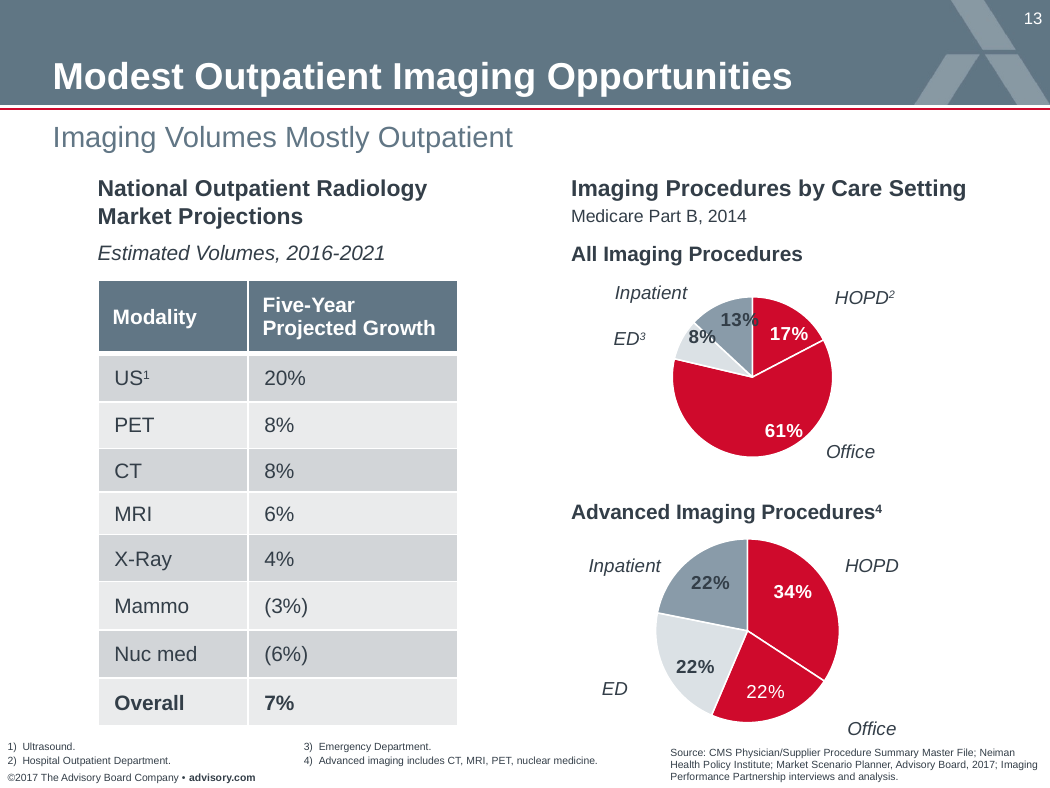
In the All Imaging Procedures pie chart, what share of procedures is in the HOPD setting? 17% Which is larger: the Inpatient share in the All Imaging Procedures chart or the Inpatient share in the Advanced Imaging Procedures chart? Advanced Imaging Procedures (22%) In the All Imaging Procedures pie chart, what share of procedures is in the Office setting? 61% In the All Imaging Procedures pie chart, what is the difference between the Office share and the HOPD share? 44 percentage points In the All Imaging Procedures pie chart, what share of procedures is Inpatient? 13% In the Advanced Imaging Procedures pie chart, which care setting has the largest share? HOPD In the Advanced Imaging Procedures pie chart, what share of procedures is in the HOPD setting? 34% In the Advanced Imaging Procedures pie chart, what share of procedures is in the Office setting? 22% In the All Imaging Procedures pie chart, which care setting has the smallest share? ED What type of chart is used to show Imaging Procedures by Care Setting? Pie chart How many care-setting slices does the Advanced Imaging Procedures pie chart have? 4 In the All Imaging Procedures pie chart, which care setting has the largest share? Office